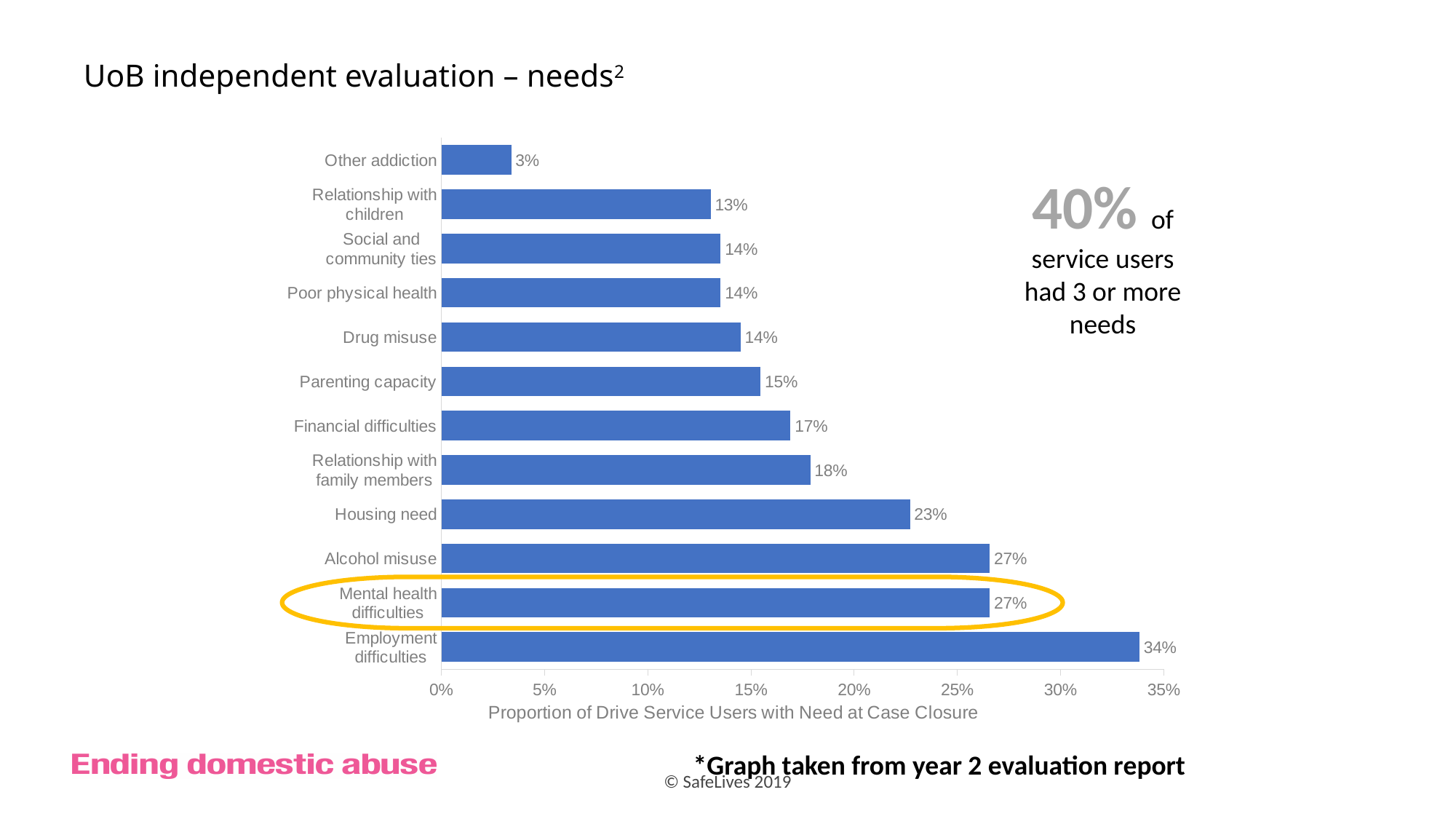
Which category has the highest value? Employment difficulties What is the value for Relationship with family members? 18% What is the value for Other addiction? 3% Is the value for Alcohol misuse greater or less than 25%? greater How many categories are shown in the chart? 12 What is the difference between the values for Employment difficulties and Housing need? 11% Which category has the lowest value? Other addiction What is the label on the horizontal axis of the chart? Proportion of Drive Service Users with Need at Case Closure Which is larger, the value for Financial difficulties or the value for Parenting capacity? Financial difficulties What is the value for Housing need? 23% What is the value for Employment difficulties? 34% What kind of chart is shown on the slide? bar chart